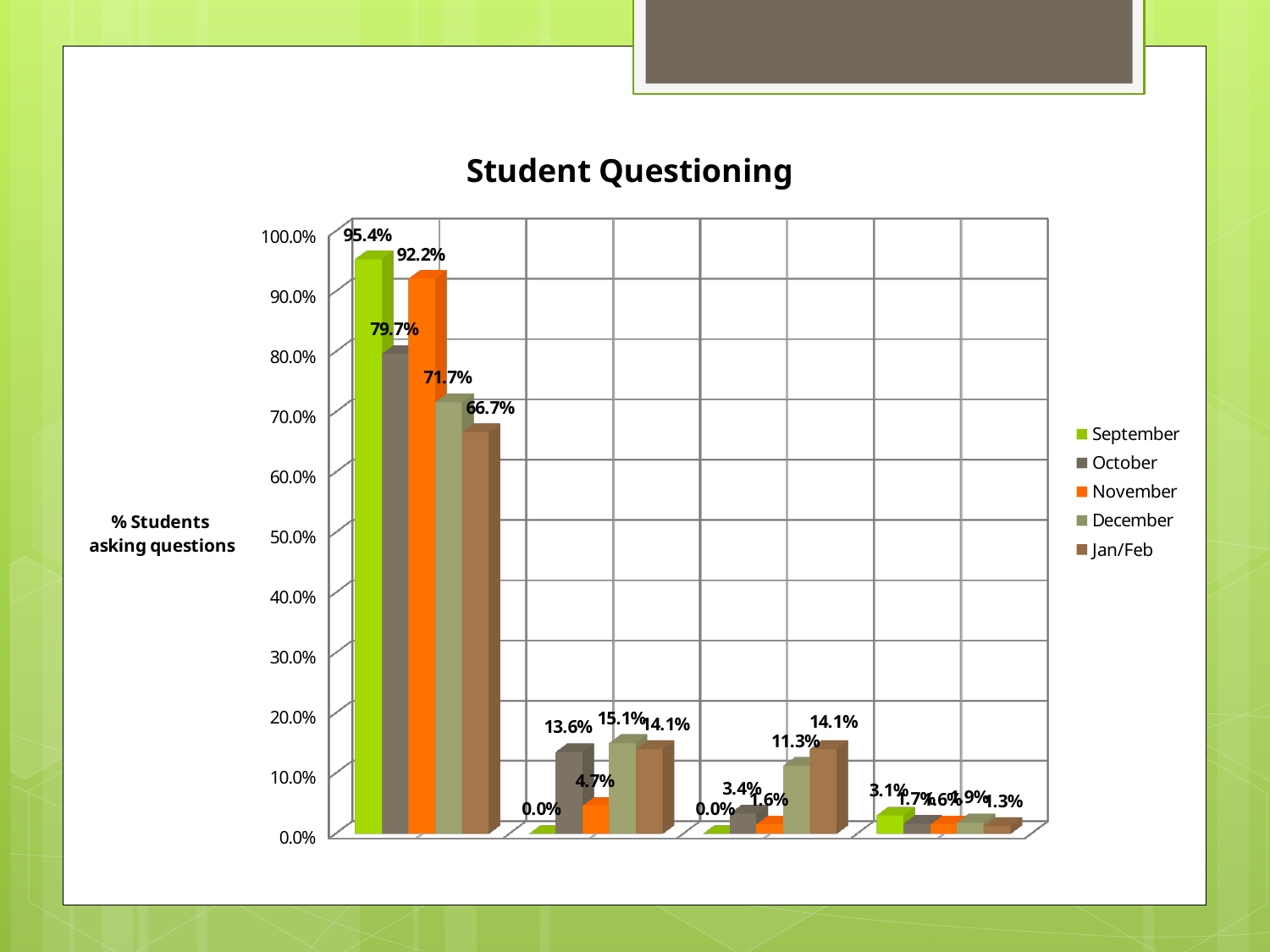
In the leftmost group of bars, what is the difference between the September value and the November value? 3.2% What is the title of the chart? Student Questioning In the leftmost group of bars, which series has the lowest value? Jan/Feb In the leftmost group of bars, which series has the highest value? September How many series does the legend of the Student Questioning chart list? 5 In the leftmost group of bars, what is the value for September? 95.4% What kind of chart is shown on the slide? bar chart In the leftmost group of bars, is the value for November greater or less than 90.0%? greater What is the label on the vertical axis of the chart? % Students asking questions In the leftmost group of bars, what is the value for Jan/Feb? 66.7% How many groups of bars are plotted along the x axis? 4 In the second group of bars from the left, which is larger: the October value or the December value? December